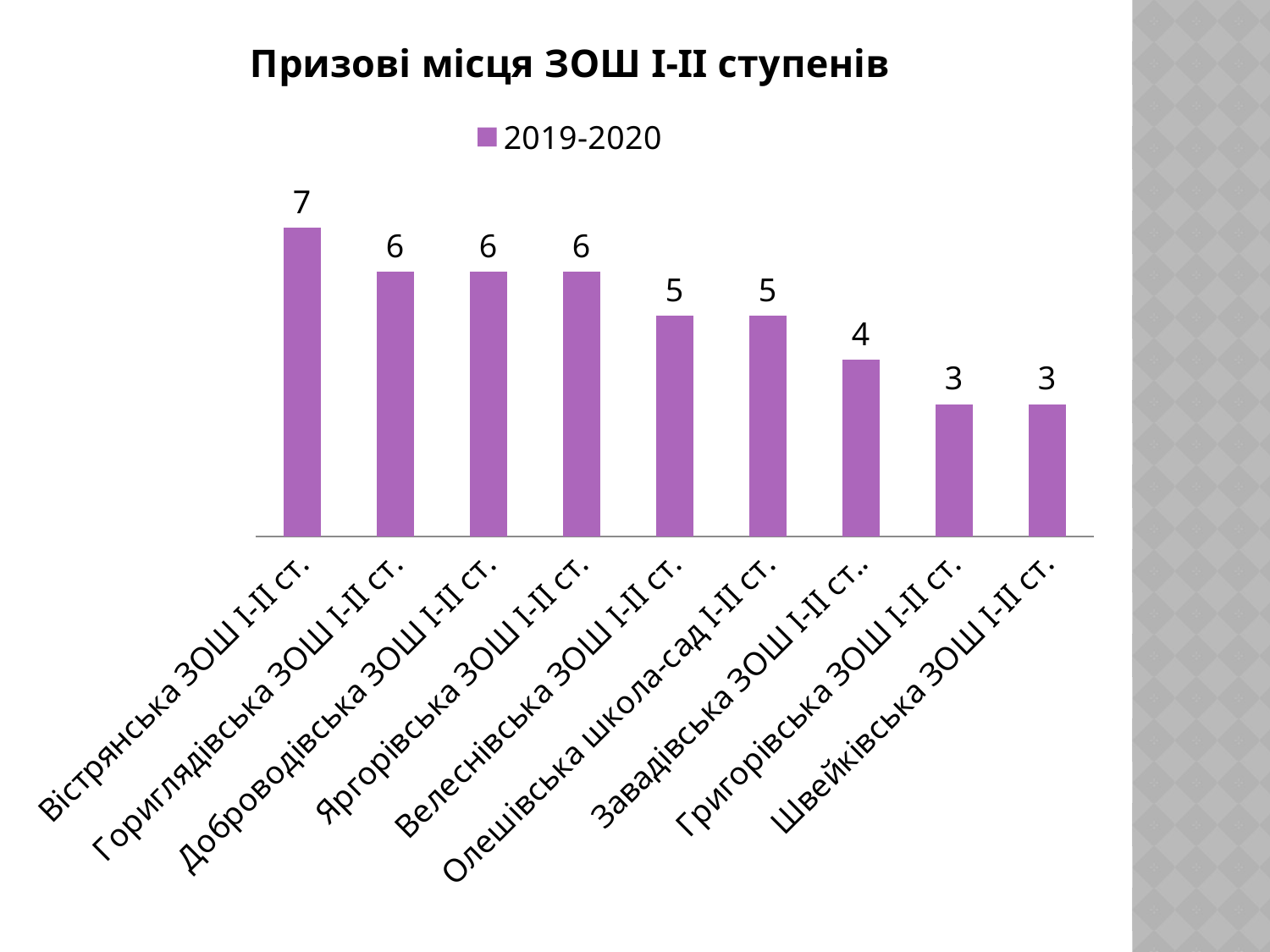
How many schools are shown on the chart? 9 What value is shown for Швейківська ЗОШ І-ІІ ст.? 3 What is the difference between the values for Вістрянська ЗОШ І-ІІ ст. and Григорівська ЗОШ І-ІІ ст.? 4 What value is shown for Завадівська ЗОШ І-ІІ ст.? 4 What is the difference between the values for Яргорівська ЗОШ І-ІІ ст. and Завадівська ЗОШ І-ІІ ст.? 2 Which is larger, the value for Гориглядівська ЗОШ І-ІІ ст. or the value for Велеснівська ЗОШ І-ІІ ст.? Гориглядівська ЗОШ І-ІІ ст. What value is shown for Вістрянська ЗОШ І-ІІ ст.? 7 What value is shown for Олешівська школа-сад І-ІІ ст.? 5 Which school has the highest value on the chart? Вістрянська ЗОШ І-ІІ ст. What kind of chart is shown on the slide? Bar chart How many series does the legend list? 1 What is the title of the chart? Призові місця ЗОШ І-ІІ ступенів